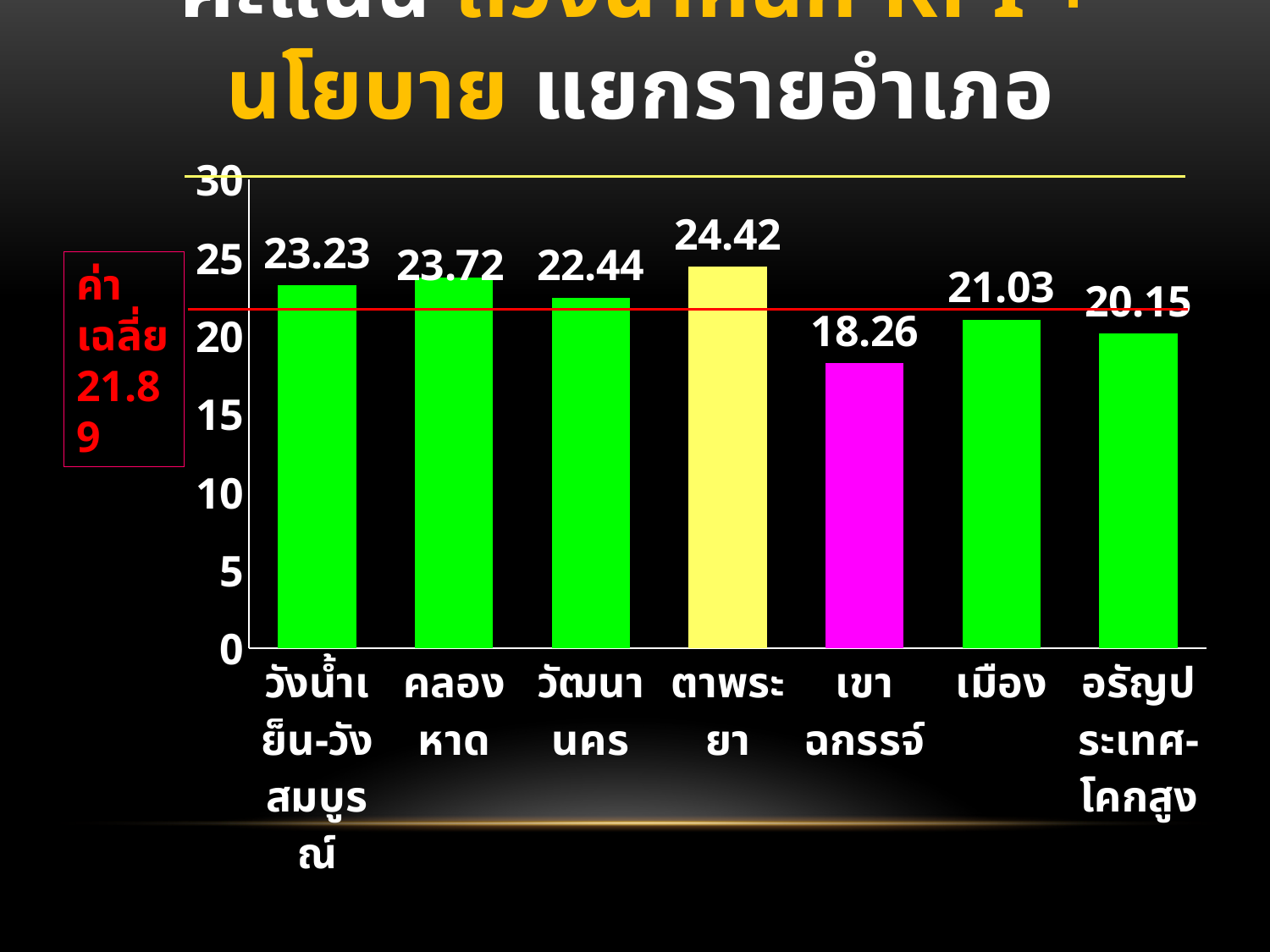
What is the value for คลองหาด? 23.72 Which district has the highest value? ตาพระยา What average value (ค่าเฉลี่ย) is shown in the red label on the chart? 21.89 Is the value for เขาฉกรรจ์ greater or less than 20? less What is the difference between the values for ตาพระยา and เขาฉกรรจ์? 6.16 What is the value for ตาพระยา? 24.42 What is the value for อรัญประเทศ-โคกสูง? 20.15 What kind of chart is shown on the slide? bar chart Which district has the lowest value? เขาฉกรรจ์ How many districts are shown on the chart? 7 What is the value for เขาฉกรรจ์? 18.26 Which is larger, the value for วัฒนานคร or the value for เมือง? วัฒนานคร